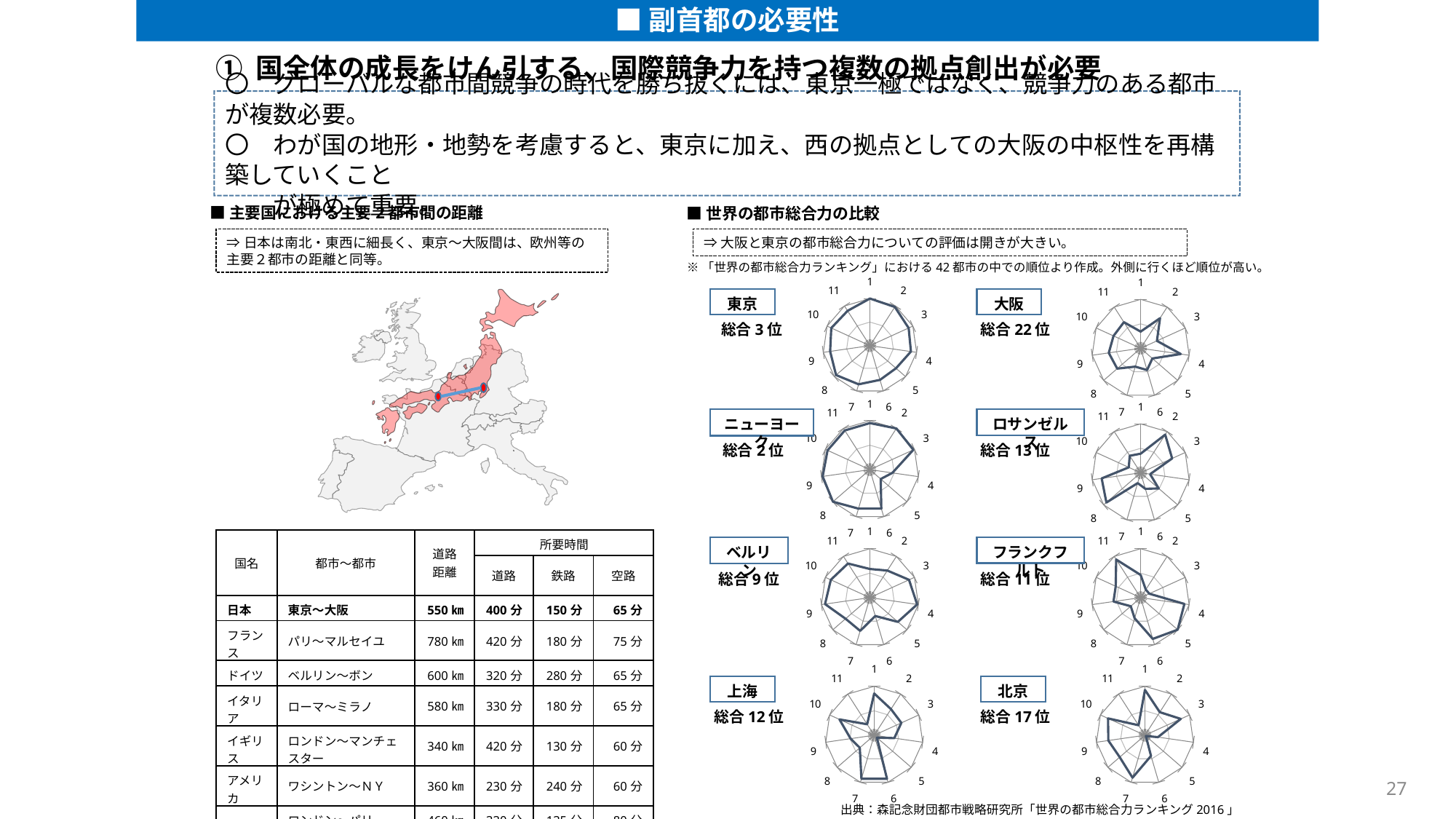
According to the note in the '世界の都市総合力の比較' section, how many cities are included in the ranking the radar charts are based on? 42都市 In the '世界の都市総合力の比較' section, what overall rank (総合) is printed for フランクフルト? 総合11位 In the '世界の都市総合力の比較' section, what overall rank (総合) is printed for 北京? 総合17位 What kind of chart is used in the '世界の都市総合力の比較' section to show each city's profile? radar chart In the '世界の都市総合力の比較' section, which city is ranked higher overall, 上海 or ロサンゼルス? 上海 How many axes (categories) does each radar chart in the '世界の都市総合力の比較' section have? 11 In the '世界の都市総合力の比較' section, what overall rank (総合) is printed for 大阪? 総合22位 Among the eight cities in the '世界の都市総合力の比較' section, which has the worst (lowest) overall rank? 大阪 How many radar charts are shown in the '世界の都市総合力の比較' section? 8 In the '世界の都市総合力の比較' section, what overall rank (総合) is printed for 東京? 総合3位 In the '世界の都市総合力の比較' section, what overall rank (総合) is printed for ニューヨーク? 総合2位 Among the eight cities in the '世界の都市総合力の比較' section, which has the best (highest) overall rank? ニューヨーク